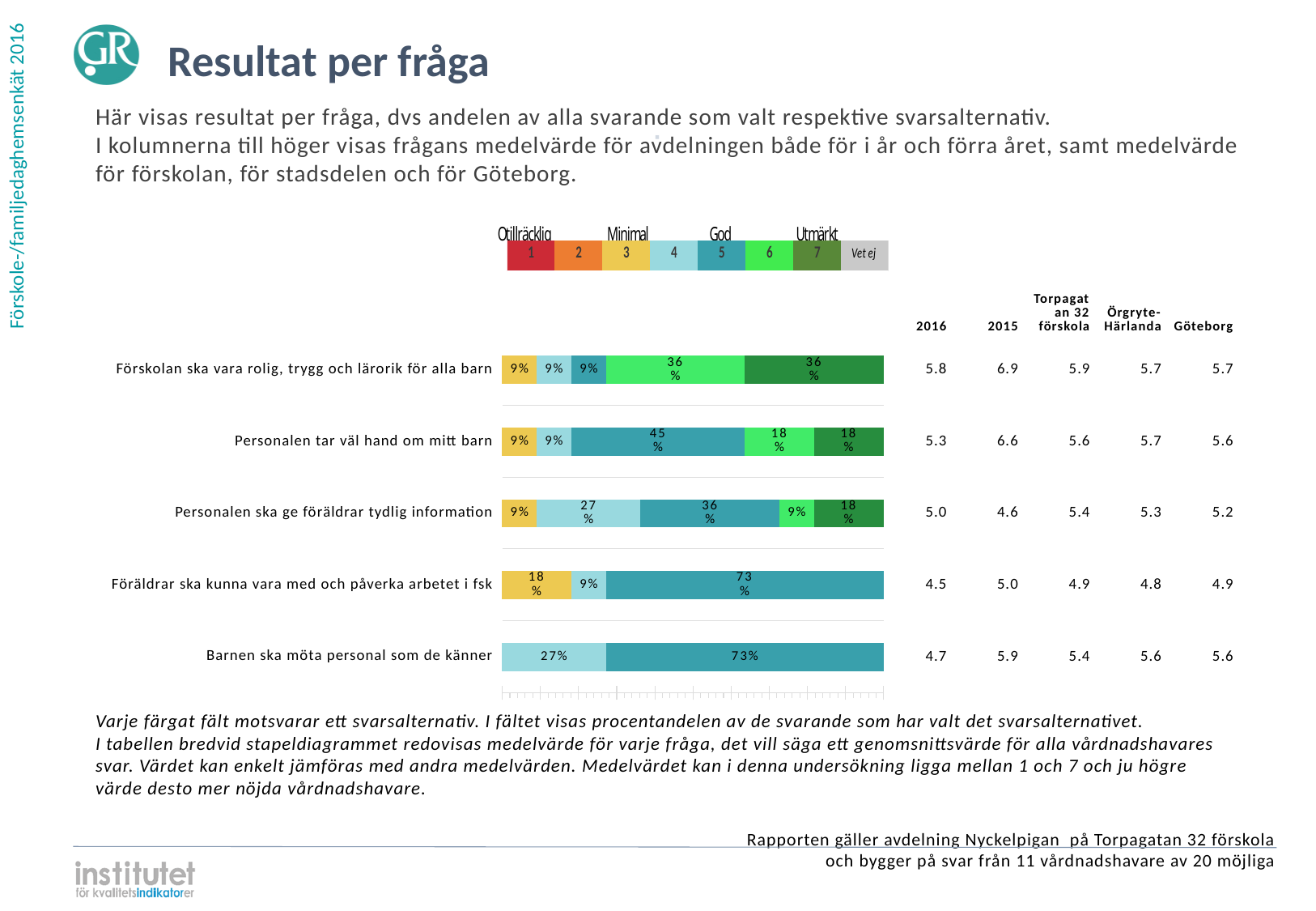
How many questions (categories) are shown in the bar chart? 5 What kind of chart is used to show the results per question? Stacked bar chart What is the difference between the 2015 and 2016 mean values for 'Personalen tar väl hand om mitt barn'? 1.3 What is the 2016 mean value for 'Föräldrar ska kunna vara med och påverka arbetet i fsk'? 4.5 How many answer alternatives does the legend above the chart list? 8 Which is larger for 'Barnen ska möta personal som de känner': the share choosing alternative 4 or the share choosing alternative 5? Alternative 5 What percentage of respondents chose alternative 7 (dark green) for 'Förskolan ska vara rolig, trygg och lärorik för alla barn'? 36% Which question has the highest 2016 mean value? Förskolan ska vara rolig, trygg och lärorik för alla barn What percentage of respondents chose alternative 4 (light blue) for 'Personalen ska ge föräldrar tydlig information'? 27% Which question has the lowest 2015 mean value? Personalen ska ge föräldrar tydlig information What percentage of respondents chose alternative 5 (teal) for 'Barnen ska möta personal som de känner'? 73% What percentage of respondents chose alternative 5 (teal) for 'Personalen tar väl hand om mitt barn'? 45%